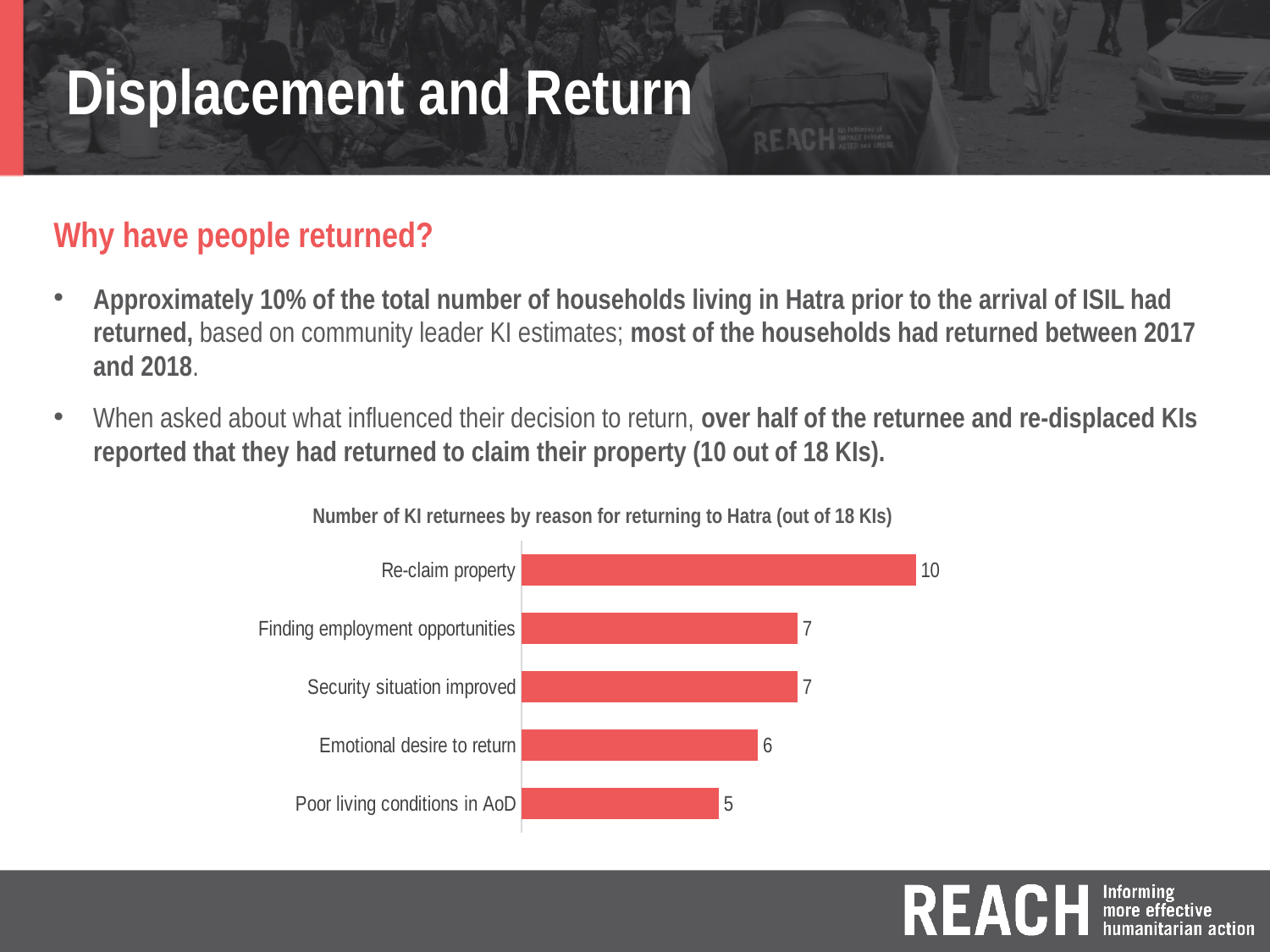
What type of chart is used to show the number of KI returnees by reason for returning? Bar chart Which was cited by more KIs: security situation improved or emotional desire to return? Security situation improved Which reason for returning to Hatra was cited by the fewest KI returnees? Poor living conditions in AoD How many KI returnees cited finding employment opportunities as a reason for returning? 7 How many KI returnees cited re-claiming property as a reason for returning to Hatra? 10 How many KI returnees cited poor living conditions in AoD as a reason for returning? 5 How many KI returnees cited emotional desire to return as a reason? 6 What is the title of the chart on the slide? Number of KI returnees by reason for returning to Hatra (out of 18 KIs) Which reason for returning to Hatra was cited by the most KI returnees? Re-claim property How many reasons for returning are shown in the chart? 5 What is the difference between the number of KIs citing re-claim property and the number citing poor living conditions in AoD? 5 Which two reasons for returning were each cited by 7 KIs? Finding employment opportunities and Security situation improved